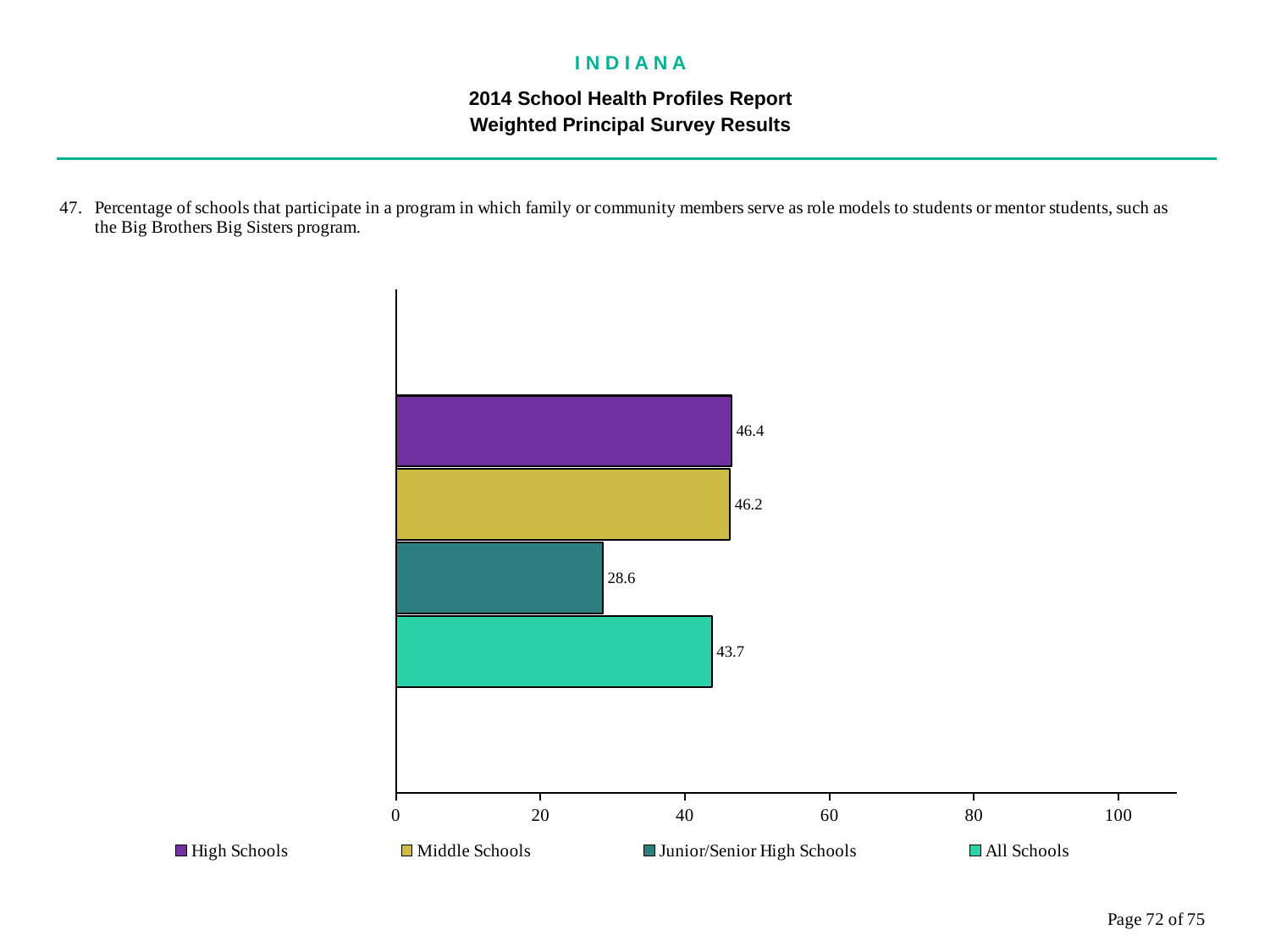
Is the value for Junior/Senior High Schools greater or less than 40? less Which is larger, the value for All Schools or the value for Junior/Senior High Schools? All Schools What is the value for Junior/Senior High Schools? 28.6 What is the difference between the values for High Schools and Junior/Senior High Schools? 17.8 Which category has the lowest value? Junior/Senior High Schools What kind of chart is shown on the slide? bar chart What is the value for High Schools? 46.4 How many entries does the legend list? 4 What is the value for Middle Schools? 46.2 How many bars are shown in the chart? 4 What is the value for All Schools? 43.7 What is the difference between the values for Middle Schools and All Schools? 2.5